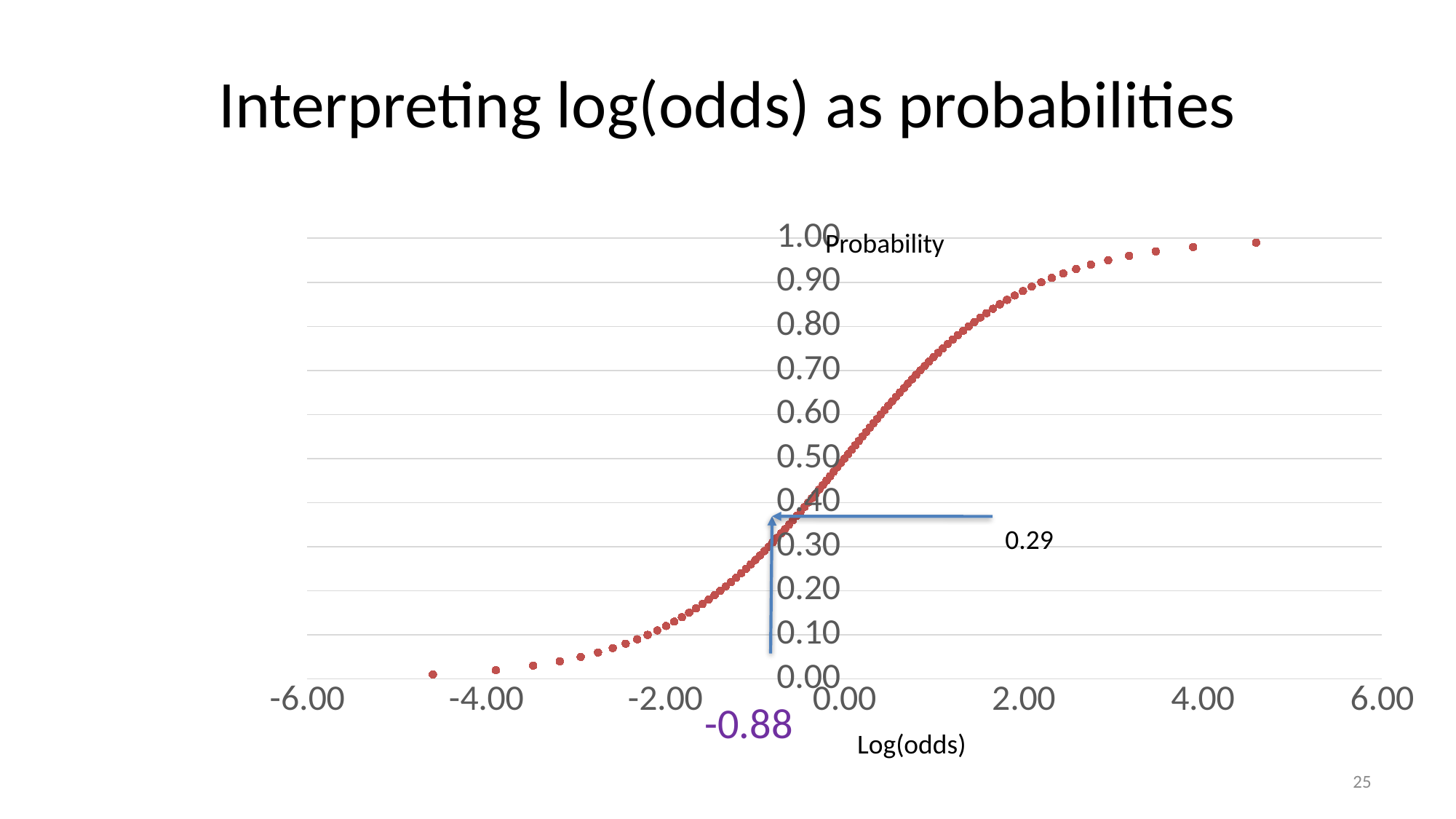
Is the probability at log(odds) = 2.00 greater or less than 0.80? greater Do the plotted probability values rise or fall as log(odds) increases along the x axis? Rise Is the probability at log(odds) = -0.88 greater or less than 0.40? less What kind of chart is shown on the slide? Scatter chart What is the label of the horizontal axis of the chart? Log(odds) Is the probability at log(odds) = 0.00 greater or less than 0.40? greater According to the annotation on the chart, what probability corresponds to a log(odds) value of -0.88? 0.29 According to the annotation on the chart, what log(odds) value corresponds to a probability of 0.29? -0.88 What is the label of the vertical axis of the chart? Probability